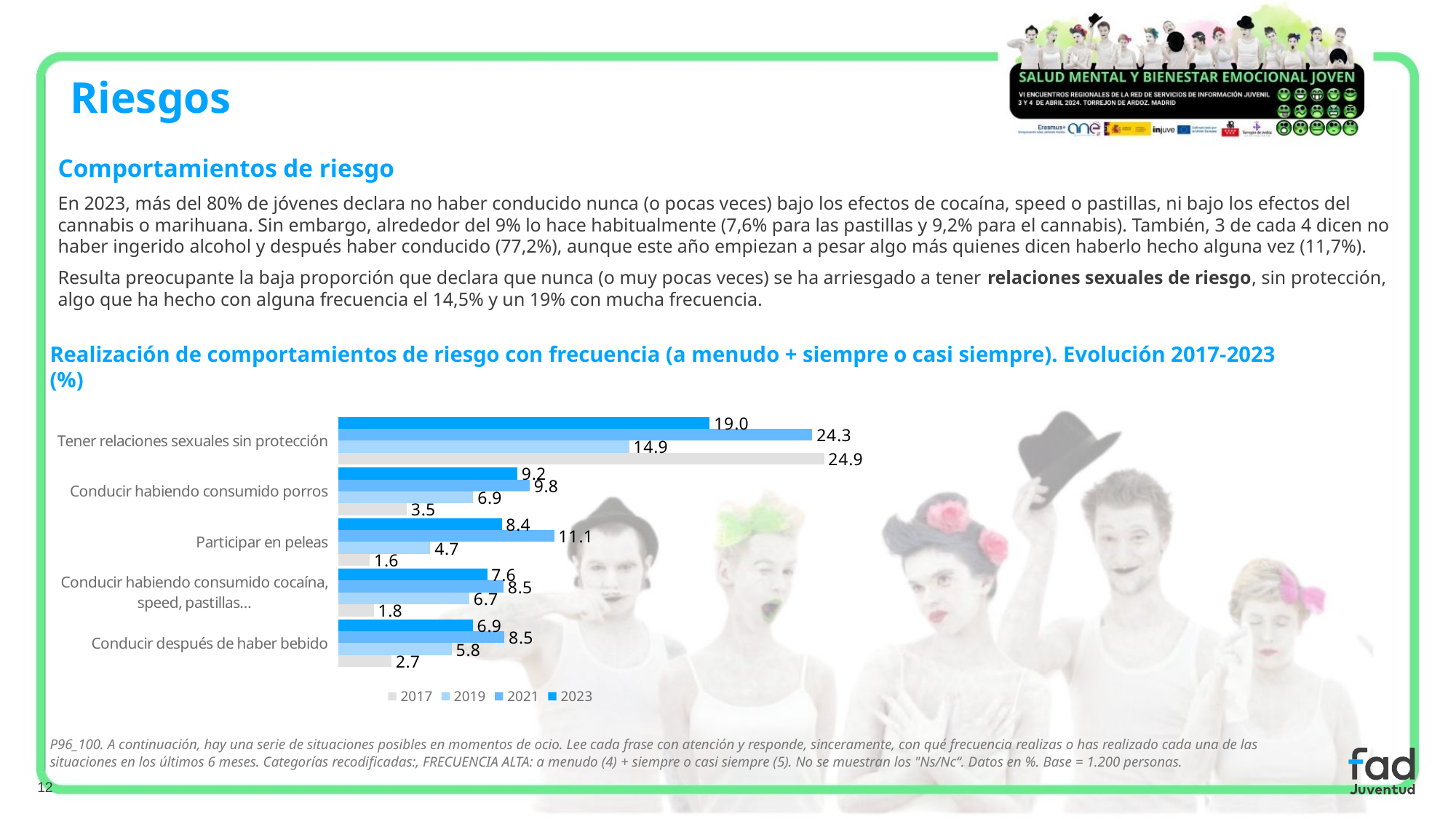
For "Conducir habiendo consumido cocaína, speed, pastillas...", which year has the larger value, 2019 or 2023? 2023 What kind of chart is shown on the slide? Bar chart What is the 2019 value for "Conducir después de haber bebido"? 5.8 Which years are listed in the chart legend? 2017, 2019, 2021, 2023 How many series does the legend list? 4 What is the 2017 value for "Participar en peleas"? 1.6 What is the difference between the 2021 and 2023 values for "Participar en peleas"? 2.7 Which category has the highest 2023 value? Tener relaciones sexuales sin protección Which category has the lowest 2017 value? Participar en peleas How many categories are shown in the chart? 5 What is the 2023 value for "Tener relaciones sexuales sin protección"? 19.0 What is the 2021 value for "Conducir habiendo consumido porros"? 9.8